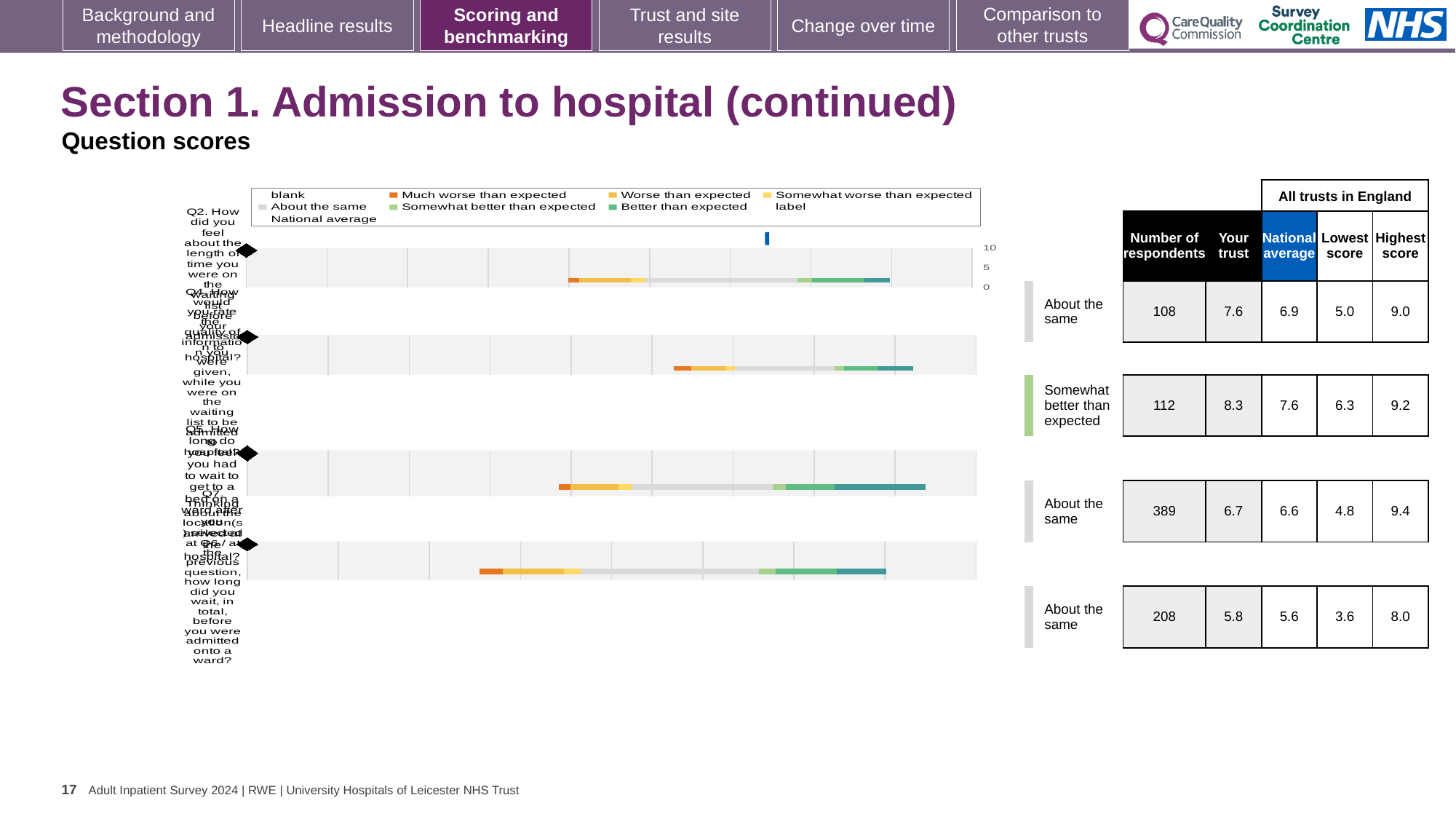
In the table beside the chart, what is the national average for the row with 389 respondents? 6.6 In the table beside the chart, what is the difference between the 'Your trust' score and the national average for the row with 112 respondents? 0.7 What is the maximum value shown on the chart's horizontal axis? 10 Which row in the table beside the chart has the largest number of respondents? the third row, 389 In the chart legend, which colour represents 'Much worse than expected'? orange In the table beside the chart, what is the highest score for the row with 112 respondents? 9.2 Which row in the table beside the chart is rated 'Somewhat better than expected'? the second row (112 respondents) Which row in the table beside the chart has the highest 'Your trust' score? the second row (112 respondents), 8.3 What kind of chart is shown on the slide? bar chart In the table beside the chart, what is the 'Your trust' score for the row with 108 respondents? 7.6 How many question rows (bars) does the chart show? 4 In the table beside the chart, what is the lowest score for the row with 208 respondents? 3.6